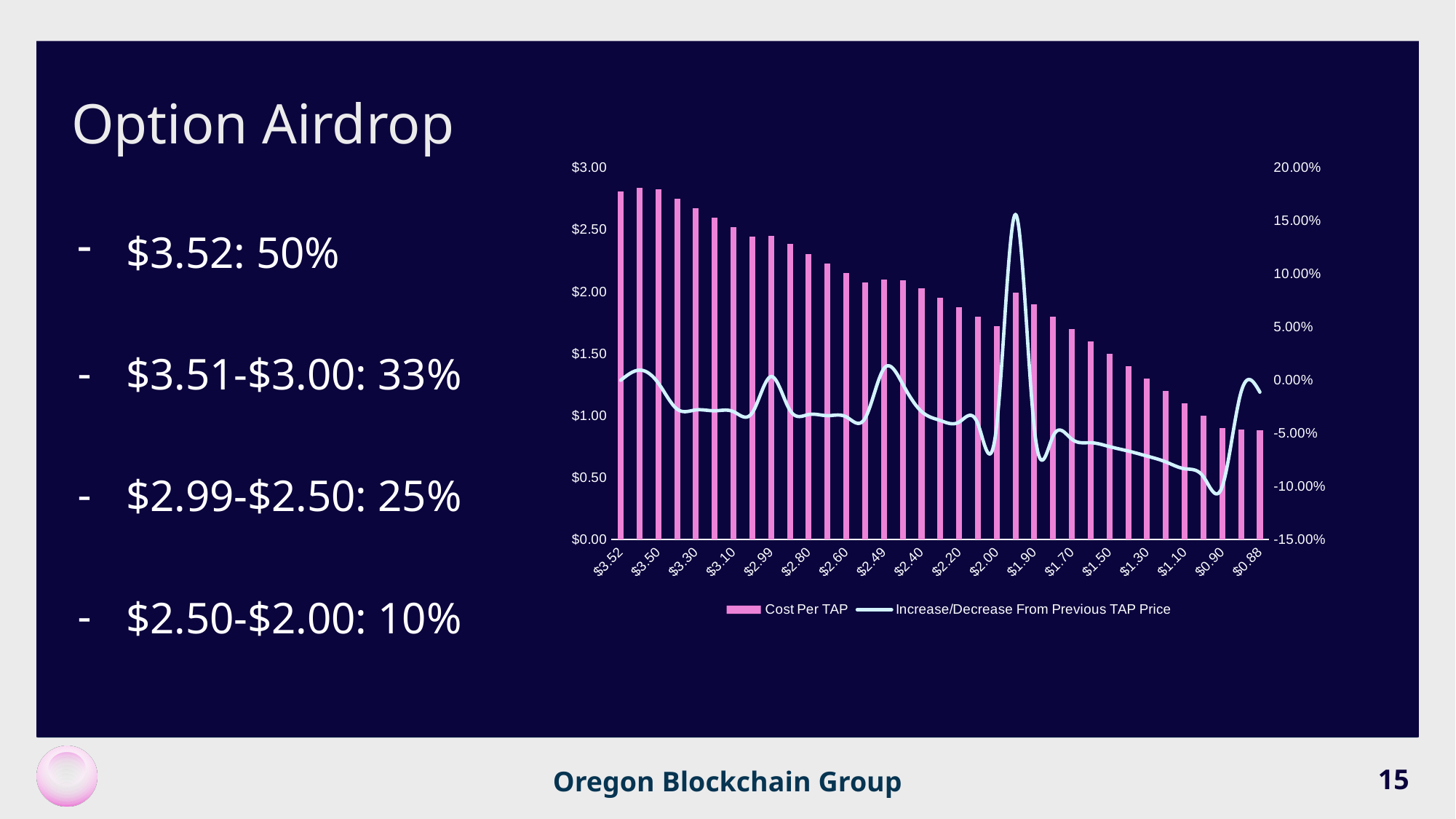
Do the Cost Per TAP bars generally rise or fall from left to right along the x axis? Fall What kind of chart is shown on the slide? A combined bar and line chart How many series does the chart legend list? 2 Is the peak of the Increase/Decrease From Previous TAP Price line near the $1.90 label greater or less than 10.00%? greater Is the Cost Per TAP value at the $3.30 label greater or less than $2.50? greater Which series is drawn as a line in the chart? Increase/Decrease From Previous TAP Price Is the Cost Per TAP value at the $2.60 label greater or less than $2.00? greater Which series is drawn as bars in the chart? Cost Per TAP How many category labels are printed along the x axis of the chart? 18